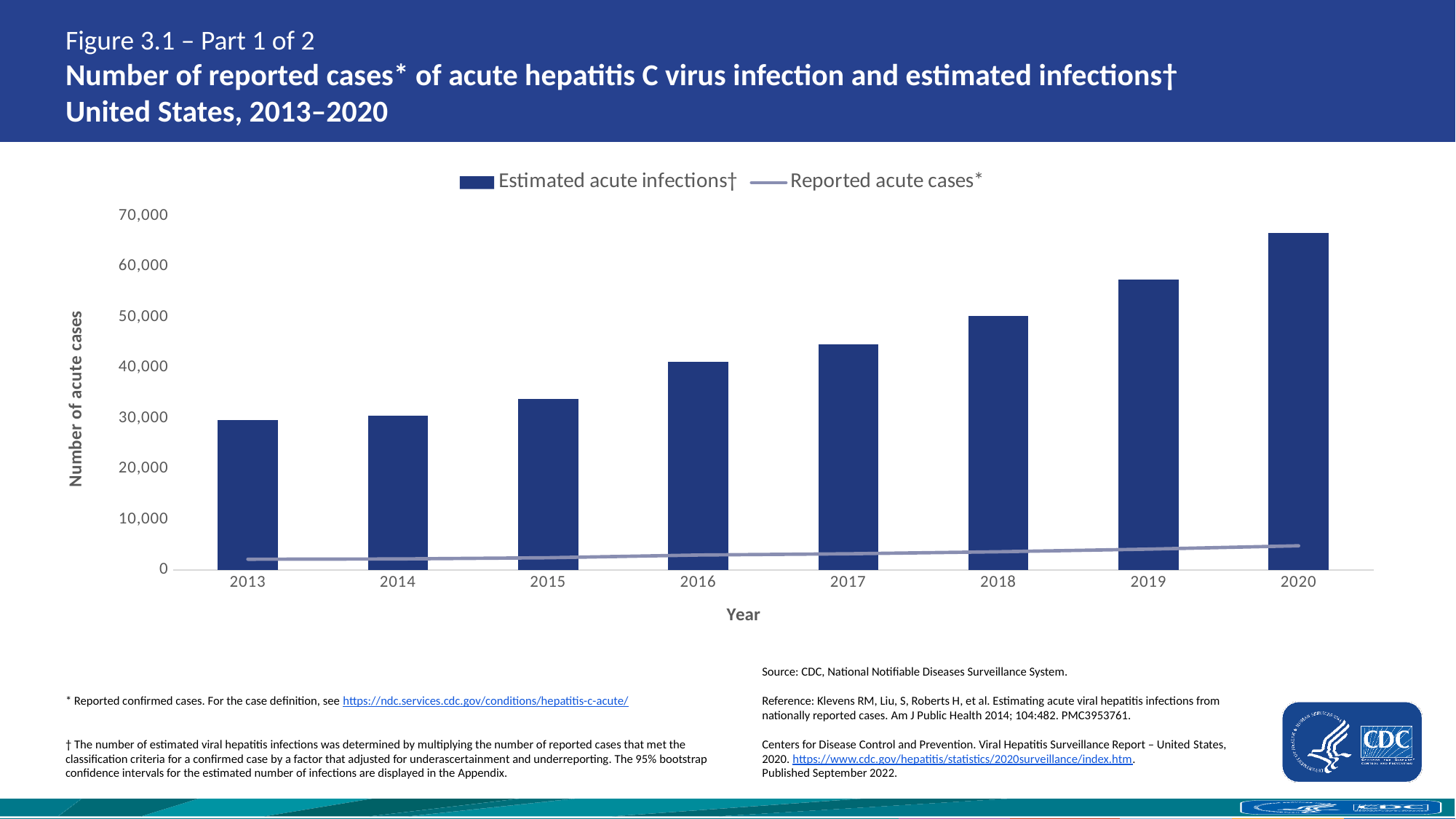
What kind of chart is shown on the slide? Bar chart with a line Which year has the larger estimated acute infections, 2016 or 2019? 2019 Do the estimated acute infections rise or fall from 2013 to 2020? Rise Which year has the highest estimated acute infections? 2020 Which series is drawn as a line in the chart? Reported acute cases* Is the value for estimated acute infections in 2014 greater or less than 40,000? less What is the label of the vertical axis? Number of acute cases Is the value for estimated acute infections in 2017 greater or less than 50,000? less Is the value for estimated acute infections in 2019 greater or less than 50,000? greater How many series does the chart legend list? 2 How many years are shown on the x axis of the chart? 8